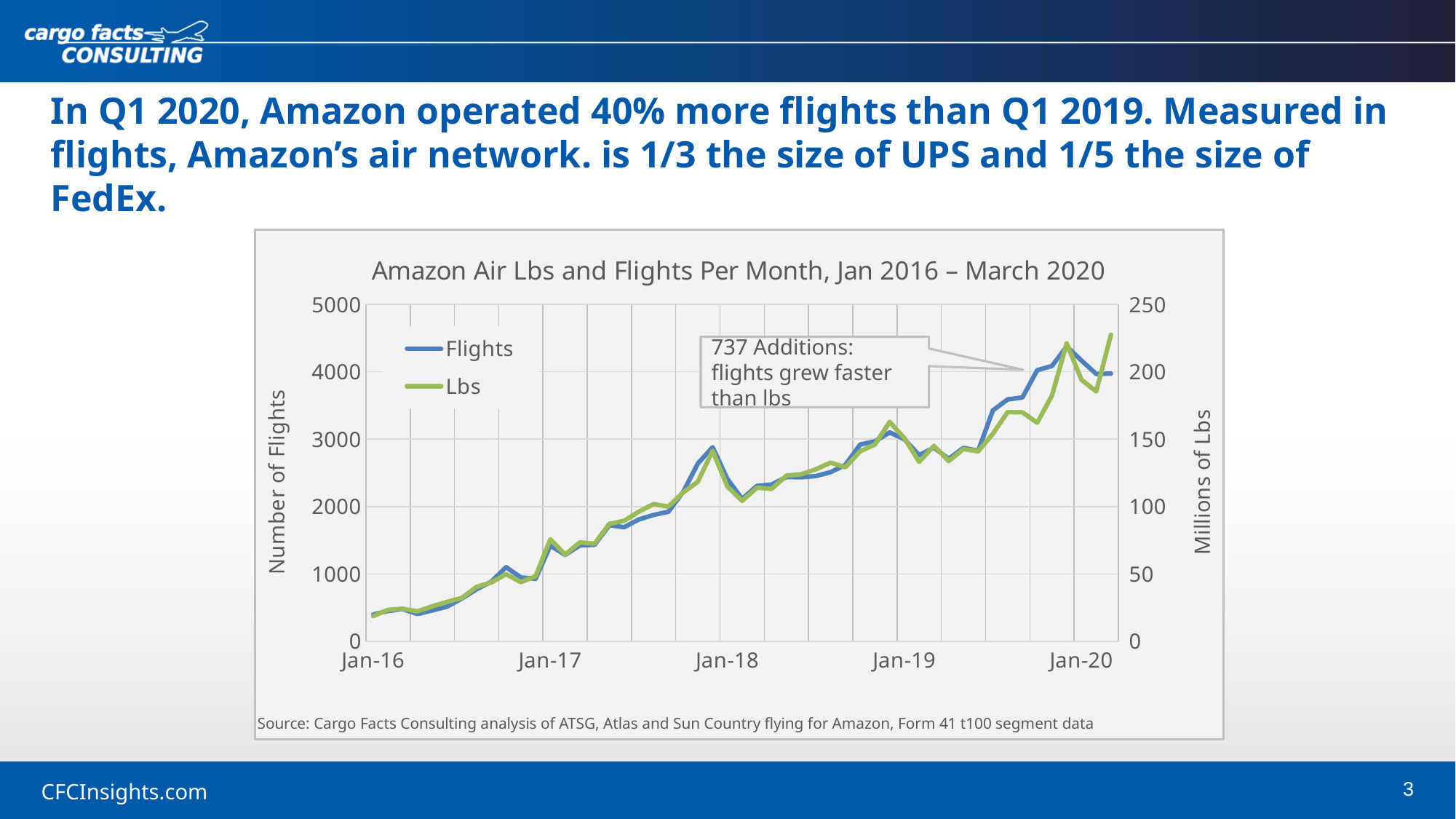
Is the Flights value at Jan-19 greater or less than 2000? greater Is the Flights value at Jan-17 greater or less than 2000? less Is the Flights value at Jan-18 greater or less than 2000? greater What is the title of the chart? Amazon Air Lbs and Flights Per Month, Jan 2016 – March 2020 What kind of chart is shown on the slide? line chart How many series does the chart's legend list? 2 What are the two series named in the chart's legend? Flights and Lbs Overall, do the Flights values rise or fall from Jan-16 to Jan-20? rise